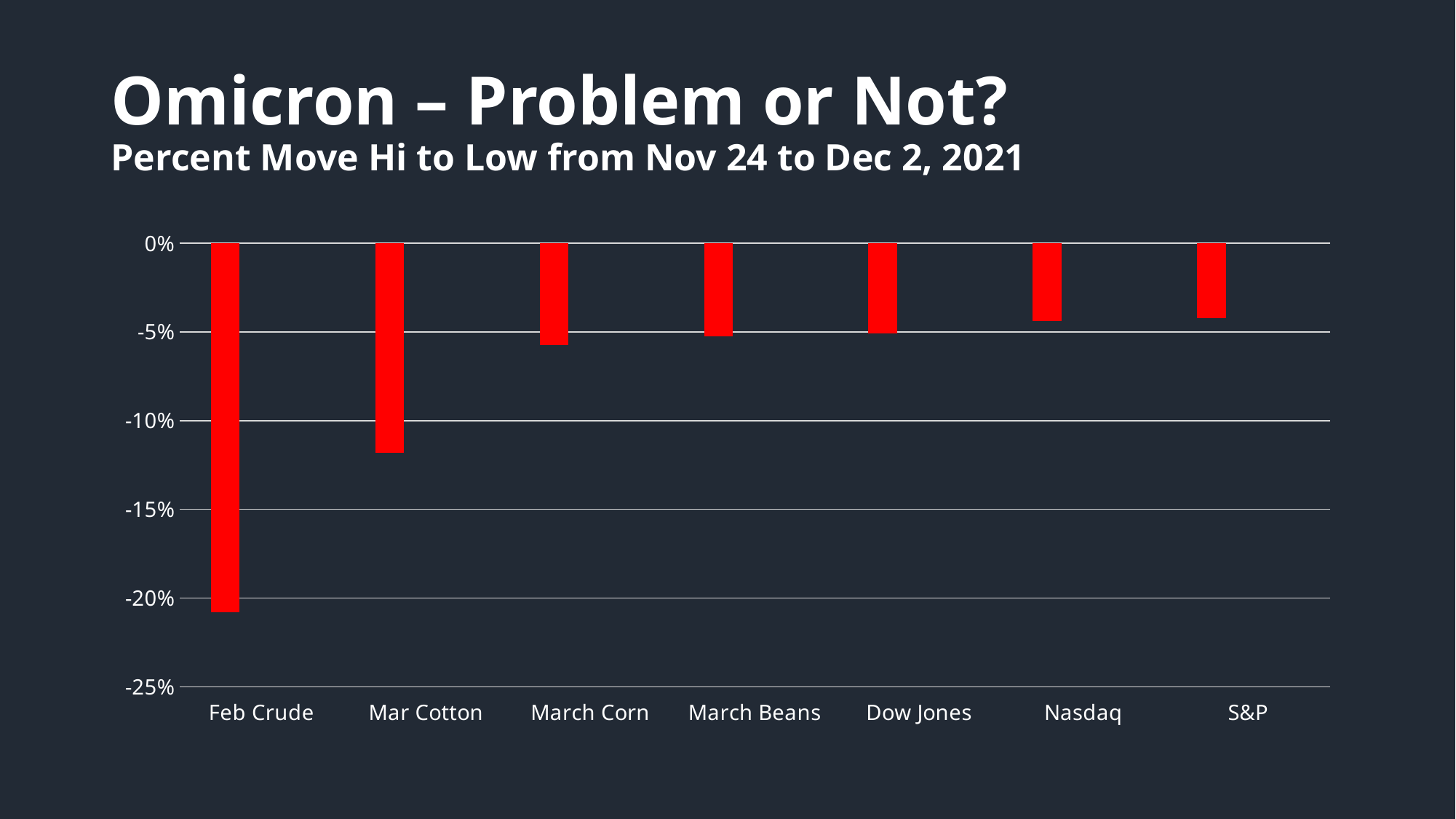
Is the value for S&P greater or less than -5%? greater Is the value for March Corn greater or less than -5%? less Which category has the lowest value (largest percent decline)? Feb Crude How many categories are plotted on the chart? 7 Which has the larger (less negative) value, Feb Crude or Mar Cotton? Mar Cotton What colour are the bars in the chart? red Which has the larger (less negative) value, Mar Cotton or March Corn? March Corn What is the subtitle describing the chart's data? Percent Move Hi to Low from Nov 24 to Dec 2, 2021 Is the value for Nasdaq greater or less than -5%? greater What kind of chart is shown on the slide? bar chart